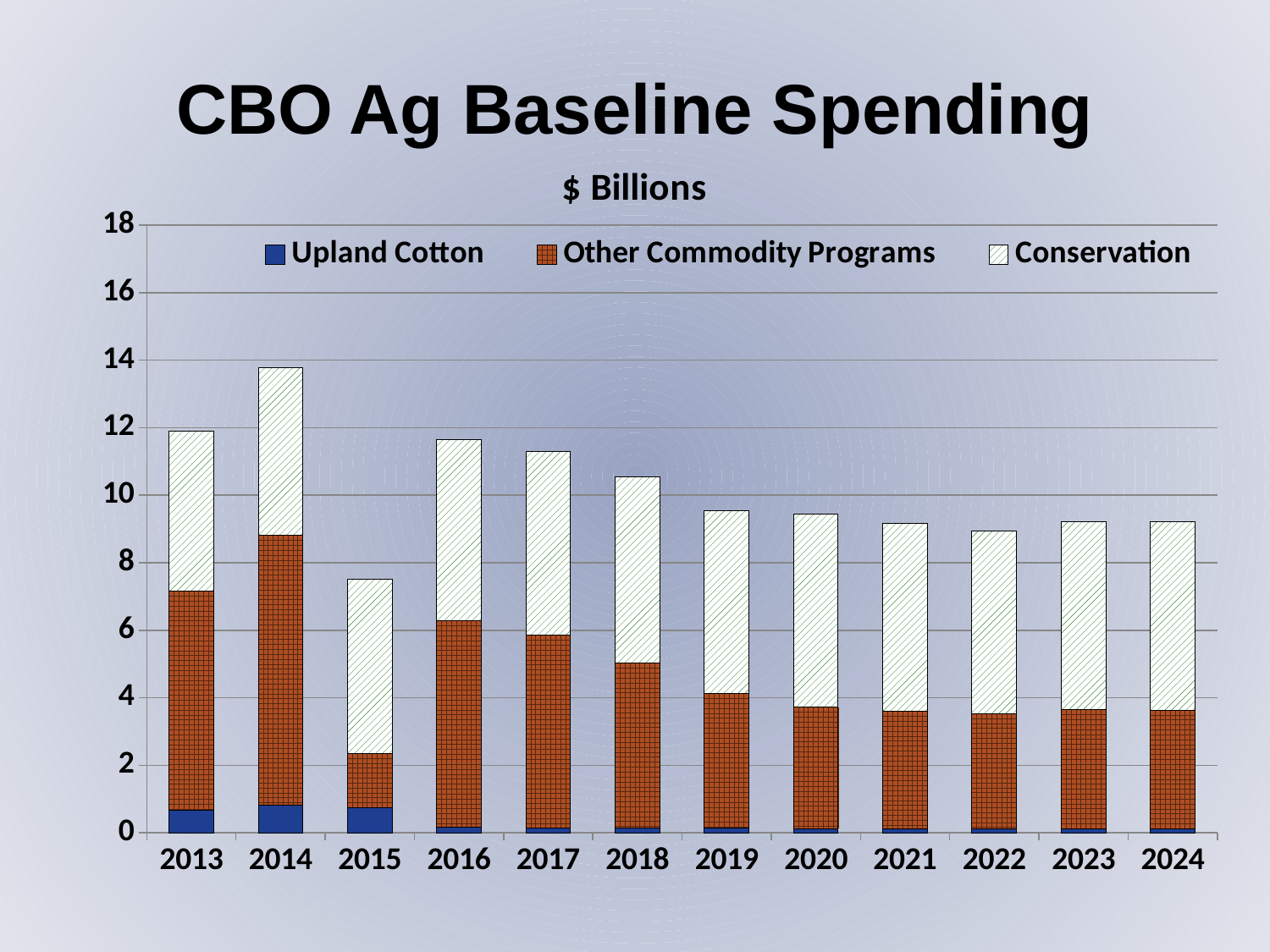
What unit is shown above the chart? $ Billions What kind of chart is shown on the slide? Stacked bar chart How many years are shown along the x axis of the chart? 12 What is the title of the slide's chart? $ Billions Which year has the taller total bar, 2013 or 2018? 2013 Is the total bar for 2014 greater or less than 12? greater Which year has the shortest total bar? 2015 Which year has the tallest total bar? 2014 Do the total bars generally rise or fall from 2016 to 2022? fall Is the total bar for 2015 greater or less than 8? less How many series does the chart's legend list? 3 Is the total bar for 2024 greater or less than 10? less